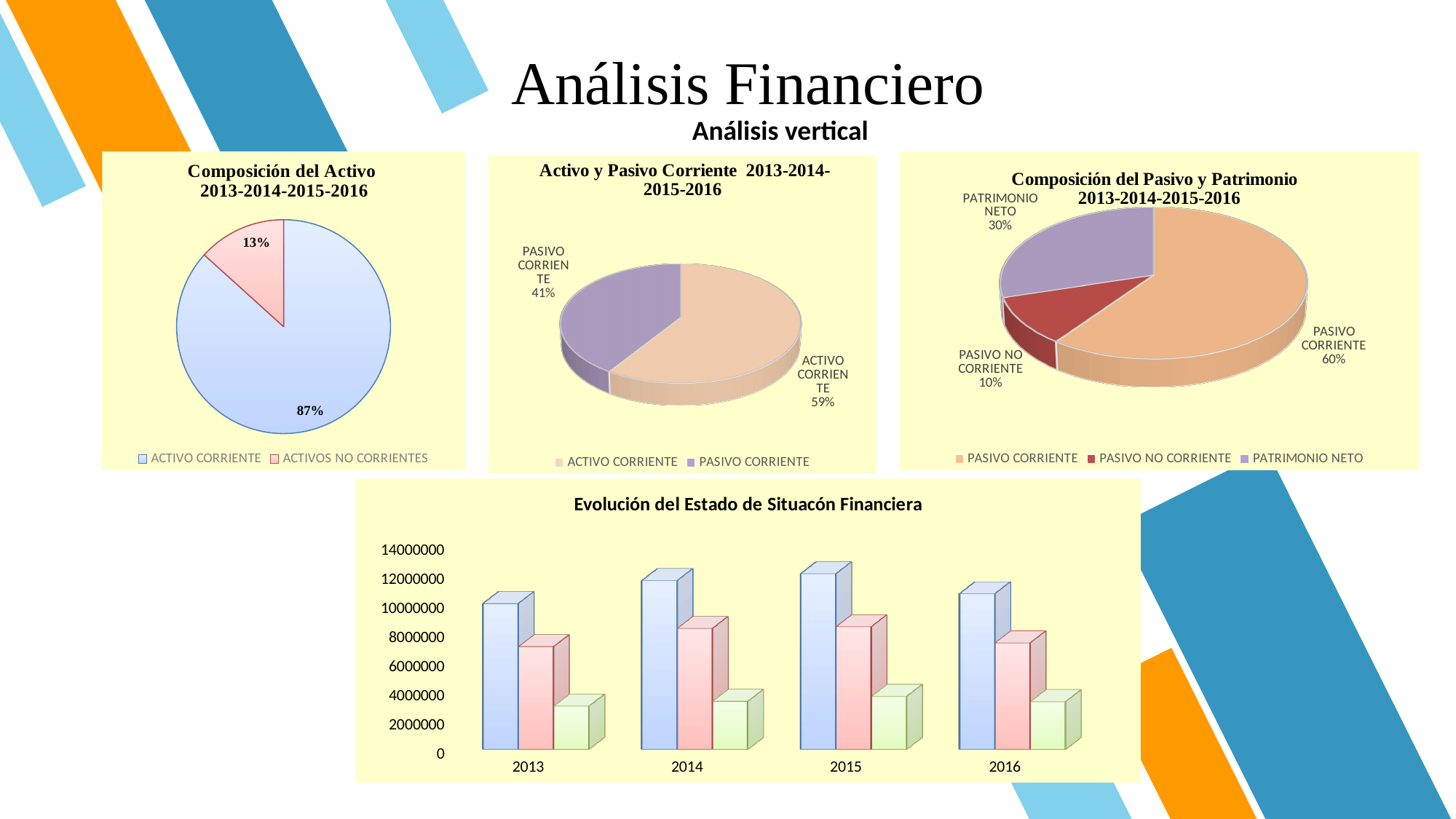
In the 'Composición del Pasivo y Patrimonio 2013-2014-2015-2016' pie chart, what is the difference in percentage points between PASIVO CORRIENTE and PATRIMONIO NETO? 30 In the 'Activo y Pasivo Corriente 2013-2014-2015-2016' pie chart, which slice is larger, ACTIVO CORRIENTE or PASIVO CORRIENTE? ACTIVO CORRIENTE In the 'Evolución del Estado de Situacón Financiera' chart, is the value of the shortest (green) bar for 2015 greater or less than 6000000? less In the 'Evolución del Estado de Situacón Financiera' chart, is the value of the tallest (blue) bar for 2014 greater or less than 10000000? greater In the 'Composición del Activo 2013-2014-2015-2016' pie chart, what share does ACTIVOS NO CORRIENTES have? 13% In the 'Composición del Pasivo y Patrimonio 2013-2014-2015-2016' pie chart, which category has the smallest share? PASIVO NO CORRIENTE What kind of chart is 'Evolución del Estado de Situacón Financiera'? bar chart How many entries does the legend of the 'Composición del Pasivo y Patrimonio 2013-2014-2015-2016' chart list? 3 In the 'Composición del Activo 2013-2014-2015-2016' pie chart, what share does ACTIVO CORRIENTE have? 87% How many years are shown on the x axis of the 'Evolución del Estado de Situacón Financiera' chart? 4 In the 'Composición del Pasivo y Patrimonio 2013-2014-2015-2016' pie chart, what percentage is PATRIMONIO NETO? 30% In the 'Activo y Pasivo Corriente 2013-2014-2015-2016' pie chart, what percentage is PASIVO CORRIENTE? 41%